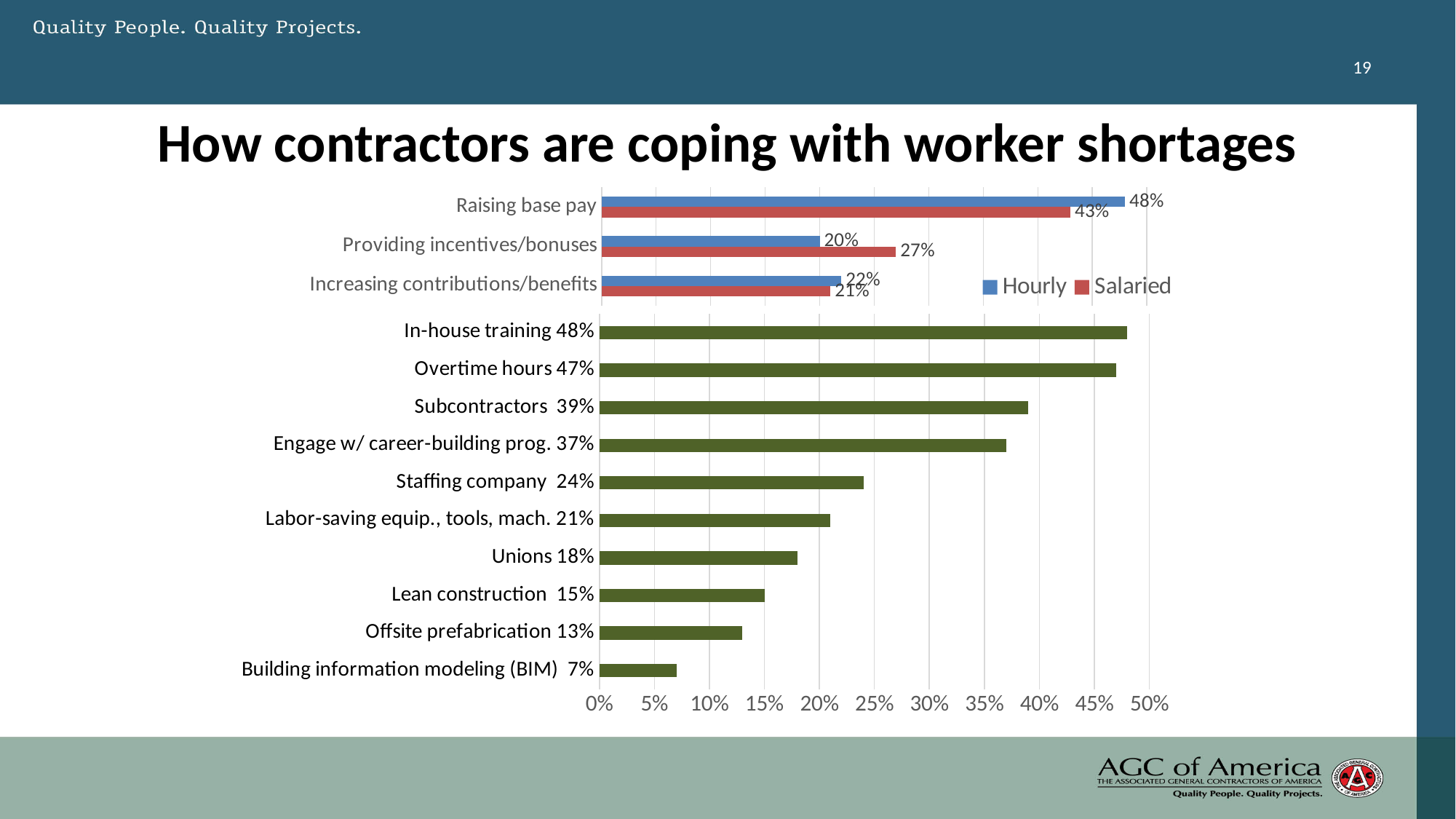
In the bottom chart, what is the difference between the values for Staffing company and Unions? 6% In the bottom chart, how many categories are plotted? 10 In the top chart (Hourly vs Salaried), what is the Salaried value for Increasing contributions/benefits? 21% In the top chart (Hourly vs Salaried), what is the difference between the Hourly and Salaried values for Raising base pay? 5% In the bottom chart, what is the value for Subcontractors? 39% What kind of chart is the bottom chart? Bar chart In the bottom chart, which category has the lowest value? Building information modeling (BIM) In the bottom chart, which category has the highest value? In-house training In the top chart (Hourly vs Salaried), what is the Salaried value for Providing incentives/bonuses? 27% In the top chart (Hourly vs Salaried), what is the Hourly value for Raising base pay? 48% In the top chart (Hourly vs Salaried), which is larger for Providing incentives/bonuses, the Hourly or the Salaried value? Salaried In the top chart (Hourly vs Salaried), how many series does the legend list? 2